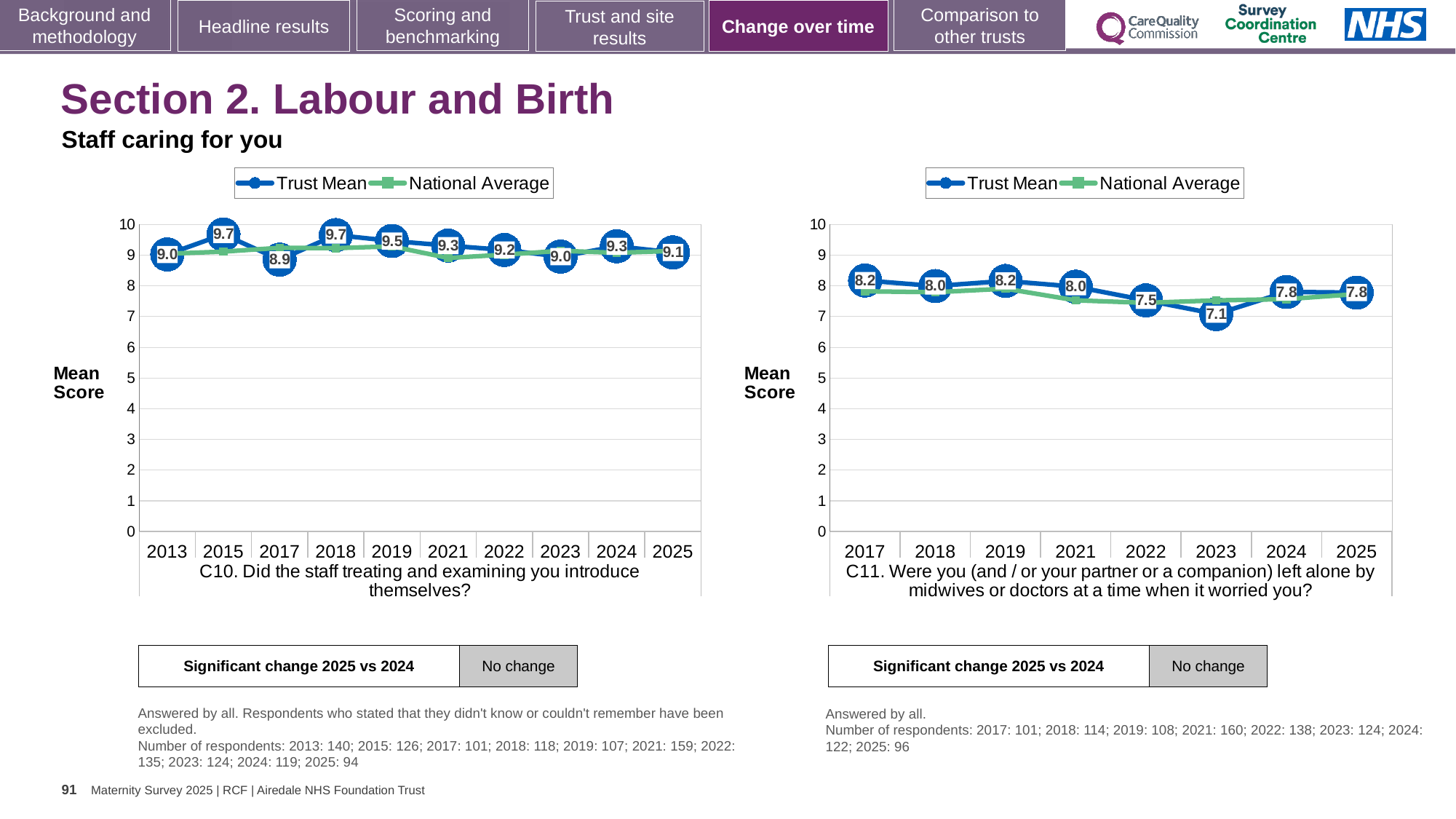
In the C11 chart on the right, is the Trust Mean score higher in 2022 or in 2024? 2024 In the C11 chart on the right, is the National Average for 2023 greater or less than 7? greater In the C10 chart on the left, what is the Trust Mean score for 2017? 8.9 In the C10 chart on the left, what is the Trust Mean score for 2025? 9.1 In the C10 chart on the left, what is the difference between the Trust Mean scores for 2018 and 2017? 0.8 In the C11 chart on the right, which year has the lowest Trust Mean score? 2023 In the C10 chart on the left, how many years are shown on the x axis? 10 In the C11 chart on the right, what is the difference between the Trust Mean scores for 2017 and 2023? 1.1 How many series does the legend of the C11 chart on the right list? 2 In the C11 chart on the right, what is the Trust Mean score for 2023? 7.1 What kind of chart is the C10 chart on the left? Line chart In the C10 chart on the left, which year has the lowest Trust Mean score? 2017